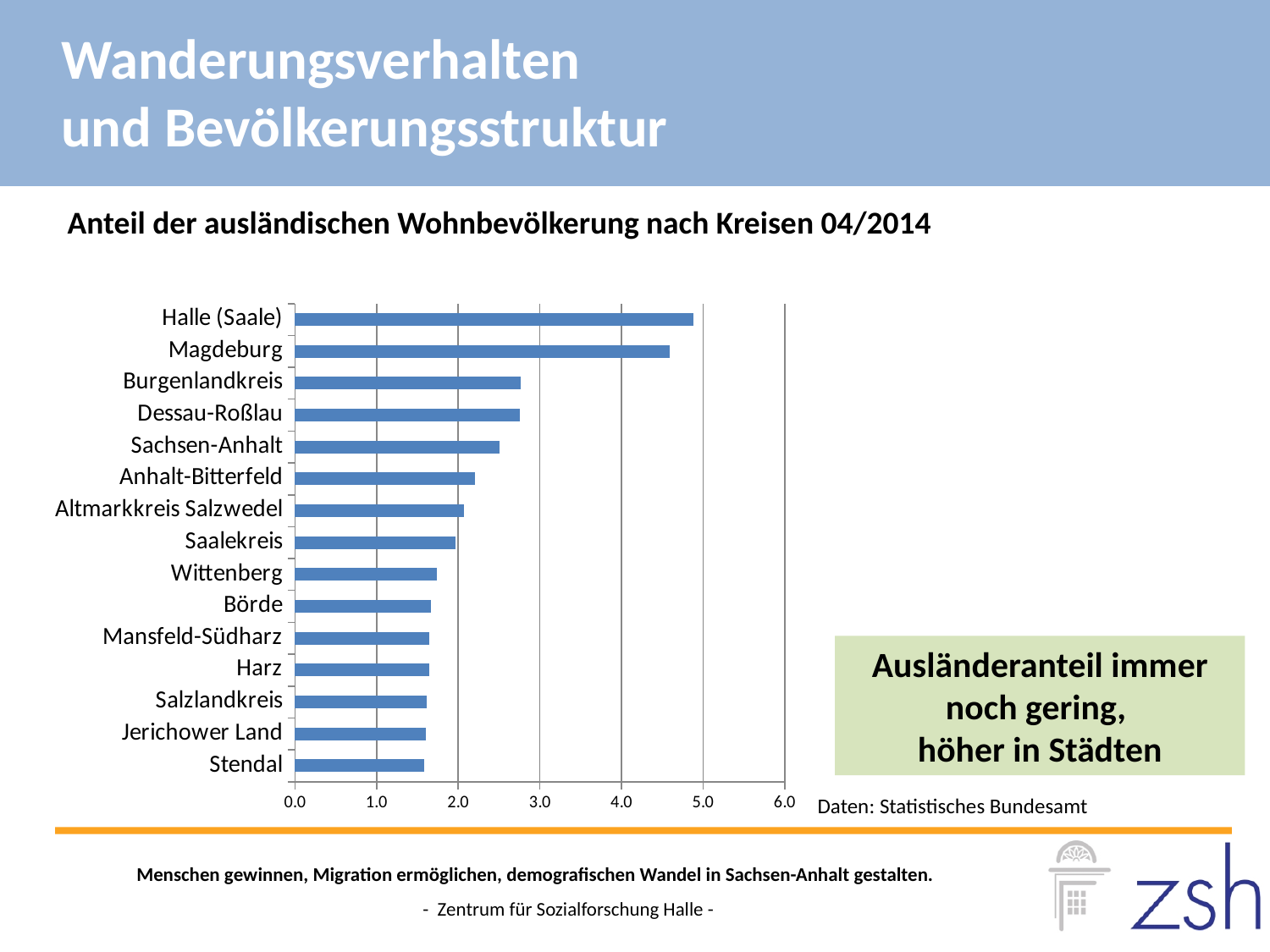
Is the value for Halle (Saale) greater or less than 4.0? greater Is the value for Stendal greater or less than 2.0? less Which has the larger value, Sachsen-Anhalt or Anhalt-Bitterfeld? Sachsen-Anhalt Which has the larger value, Magdeburg or Burgenlandkreis? Magdeburg Is the value for Magdeburg greater or less than 4.0? greater Which category has the highest share of foreign residents in the chart? Halle (Saale) How many districts/categories are plotted in the chart? 15 Which has the larger value, Halle (Saale) or Magdeburg? Halle (Saale) What kind of chart is shown on the slide? bar chart What is the title of the chart on the slide? Anteil der ausländischen Wohnbevölkerung nach Kreisen 04/2014